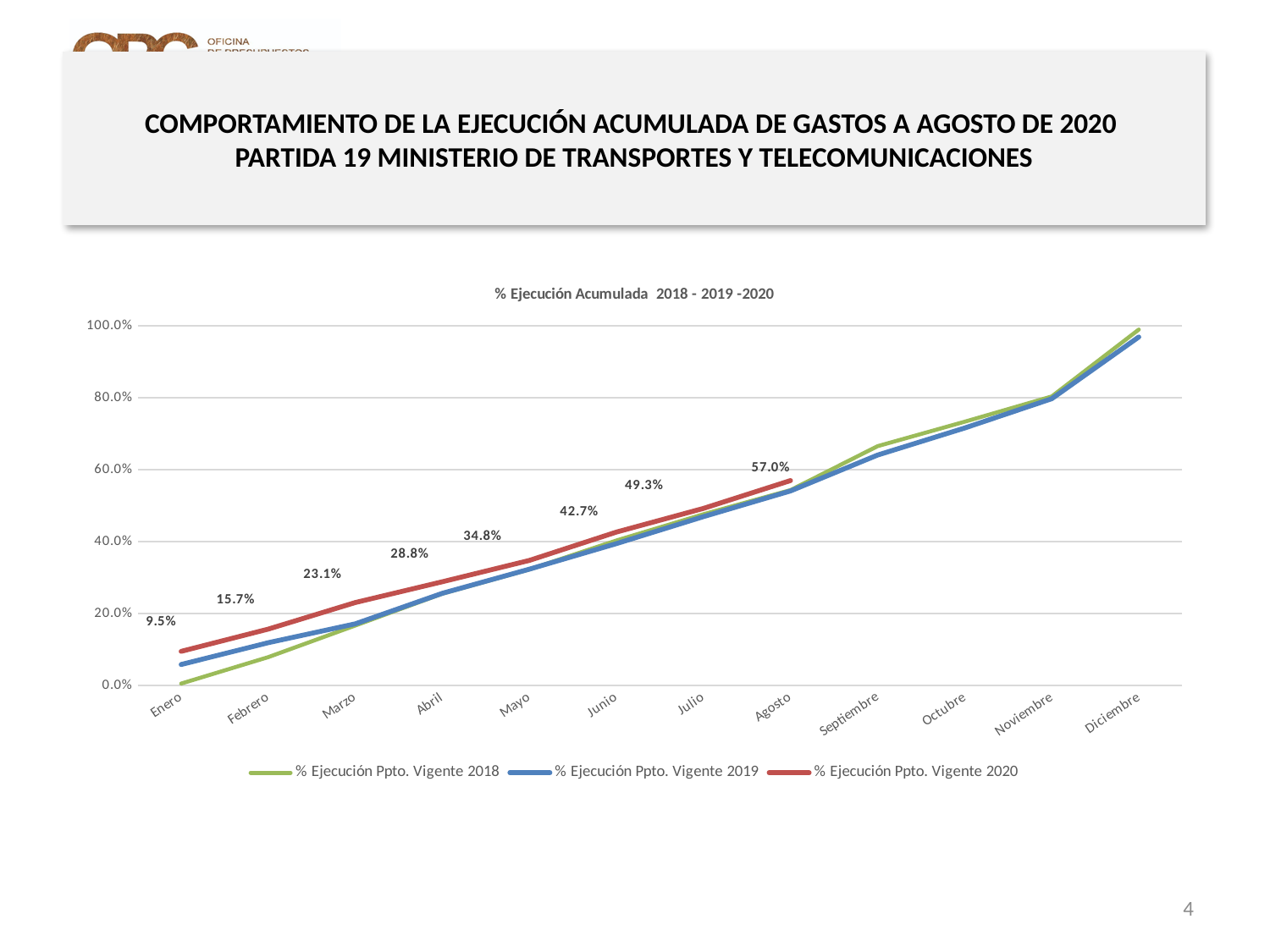
What kind of chart is shown on the slide? line chart How many series does the legend list? 3 Does the % Ejecución Ppto. Vigente 2020 line rise or fall from Enero to Agosto? rise In Enero, which series has the larger value, % Ejecución Ppto. Vigente 2020 or % Ejecución Ppto. Vigente 2018? % Ejecución Ppto. Vigente 2020 What is the value for % Ejecución Ppto. Vigente 2020 in Abril? 28.8% What is the title of the chart? % Ejecución Acumulada 2018 - 2019 -2020 What is the difference between the 2020 values for Marzo and Febrero? 7.4% How many months are shown on the x axis? 12 What is the difference between the 2020 values for Agosto and Julio? 7.7% Is the value for % Ejecución Ppto. Vigente 2018 in Diciembre greater or less than 80.0%? greater What is the value for % Ejecución Ppto. Vigente 2020 in Agosto? 57.0% What is the value for % Ejecución Ppto. Vigente 2020 in Enero? 9.5%